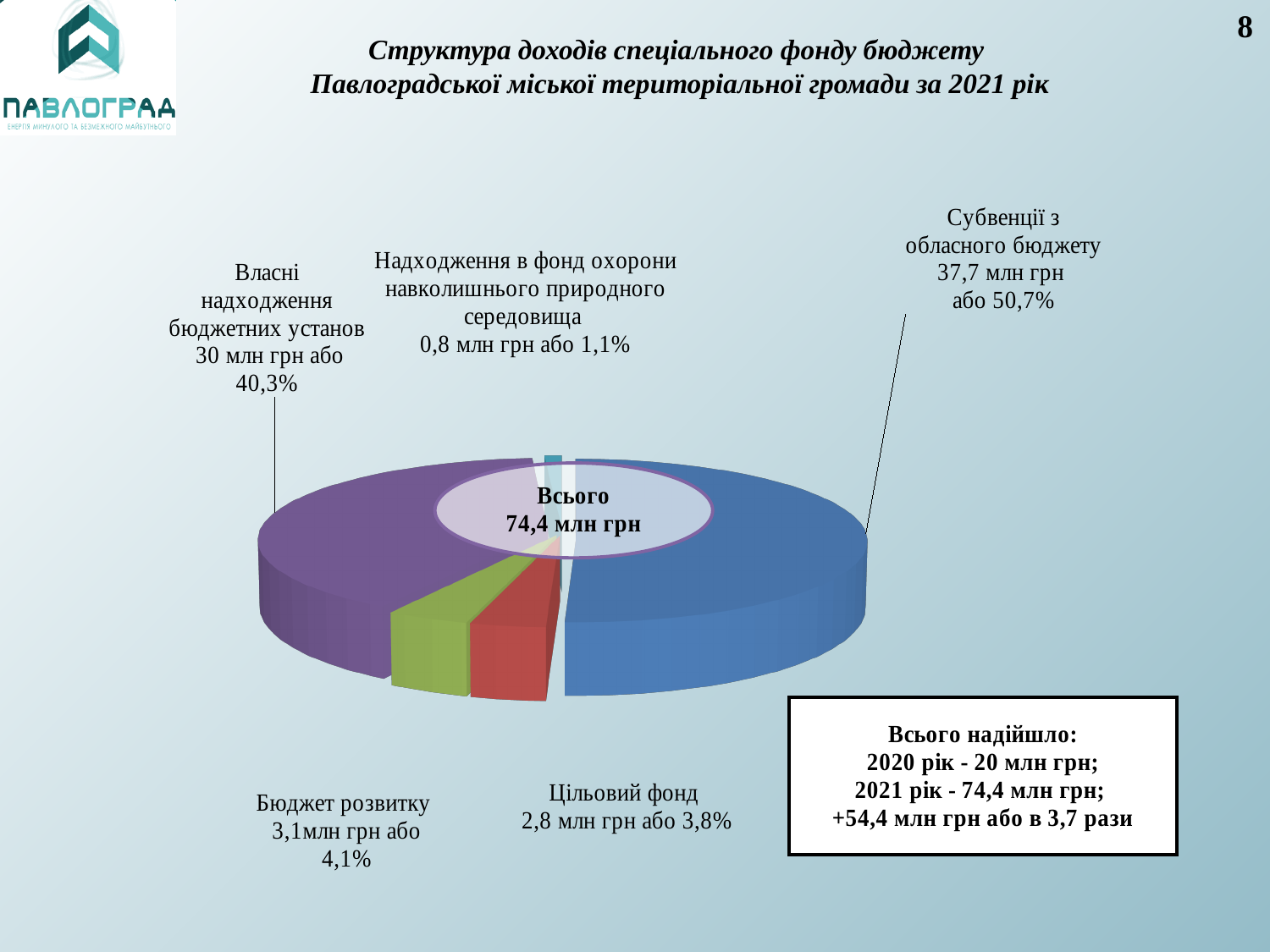
What is the value for Бюджет розвитку? 3,1 млн грн What is the value for Субвенції з обласного бюджету? 37,7 млн грн Which is larger, Бюджет розвитку or Цільовий фонд? Бюджет розвитку What total is shown in the centre of the pie chart? 74,4 млн грн How many slices does the pie chart have? 5 What is the difference in млн грн between Субвенції з обласного бюджету and Власні надходження бюджетних установ? 7,7 млн грн Which category has the largest share of the pie? Субвенції з обласного бюджету What kind of chart is shown on the slide? pie chart What is the value for Надходження в фонд охорони навколишнього природного середовища? 0,8 млн грн Which category has the smallest share of the pie? Надходження в фонд охорони навколишнього природного середовища What share of the pie does Власні надходження бюджетних установ represent? 40,3% What share of the pie does Цільовий фонд represent? 3,8%